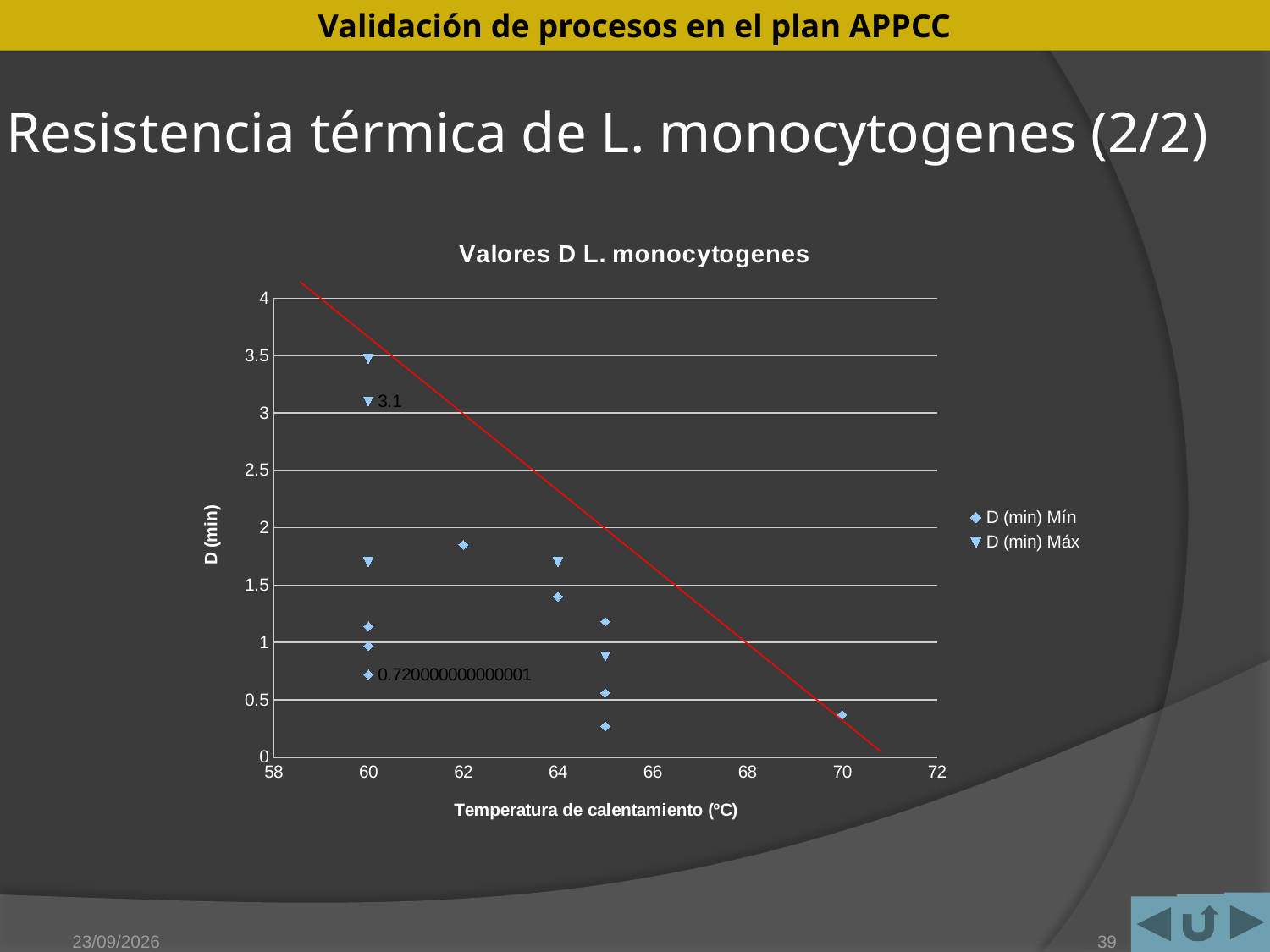
What is the title of the chart? Valores D L. monocytogenes Is the D (min) Mín value at 62 °C greater or less than 1.5? greater What is the labelled D (min) Mín value at 60 °C? 0.720000000000001 Is the highest D (min) Máx value at 60 °C greater or less than 3? greater At 64 °C, which is larger: the D (min) Máx value or the D (min) Mín value? D (min) Máx What are the two series named in the legend? D (min) Mín and D (min) Máx Is the D (min) Mín value at 70 °C greater or less than 0.5? less How many series does the chart legend list? 2 Do the D values generally rise or fall as the heating temperature increases? Fall What is the labelled D (min) Máx value at 60 °C? 3.1 At which temperature does the chart show the highest D value? 60 What kind of chart is shown on the slide? Scatter chart